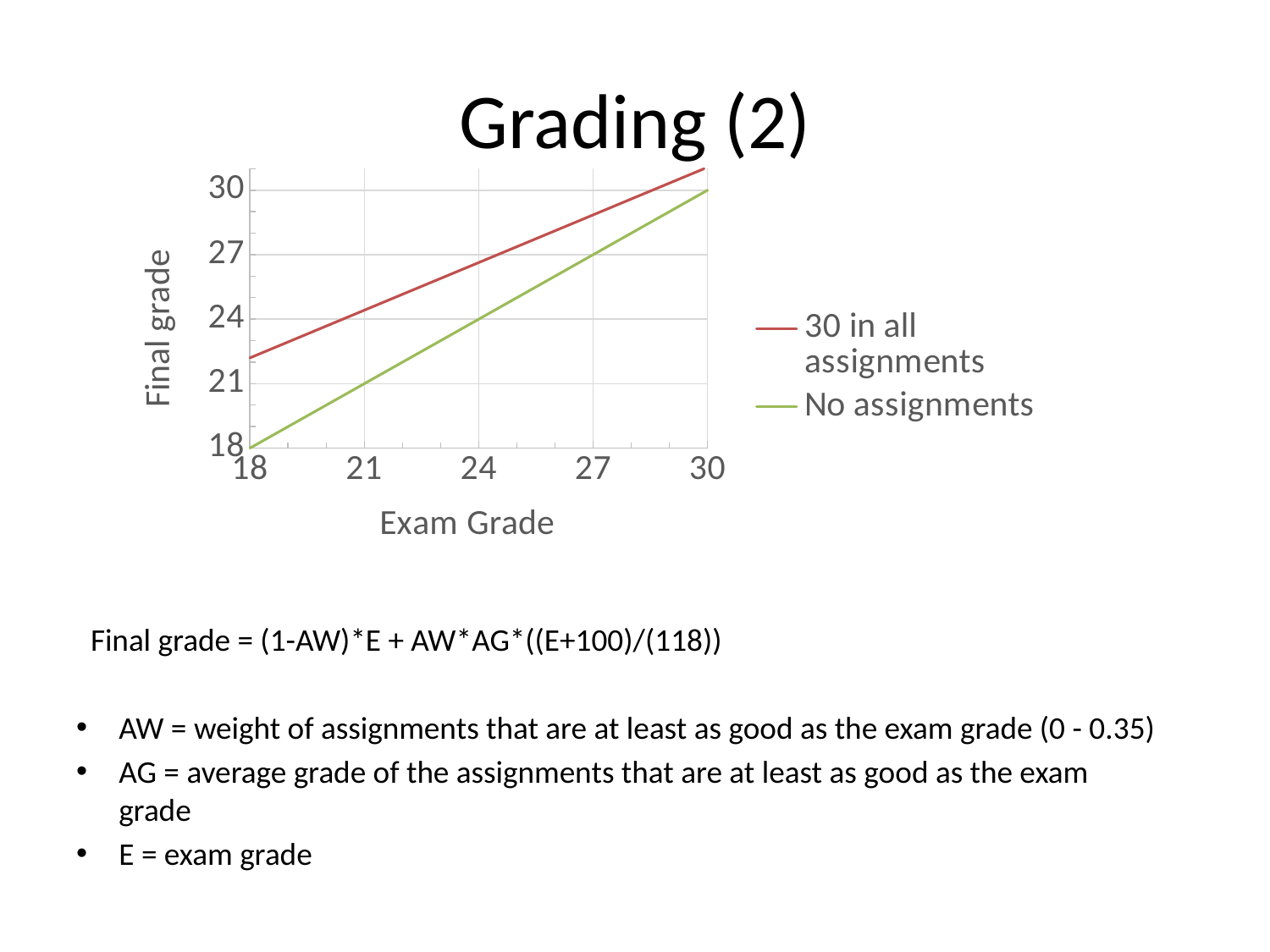
How many series does the chart legend list? 2 Is the final grade for '30 in all assignments' at an exam grade of 18 greater or less than 21? greater What is the title of the x axis of the chart? Exam Grade What is the final grade for the 'No assignments' series at an exam grade of 24? 24 What are the two series named in the chart legend? 30 in all assignments; No assignments At an exam grade of 24, which series has the higher final grade: '30 in all assignments' or 'No assignments'? 30 in all assignments What is the final grade for the 'No assignments' series at an exam grade of 18? 18 Is the final grade for 'No assignments' at an exam grade of 21 greater or less than 24? less Is the final grade for '30 in all assignments' at an exam grade of 30 greater or less than 30? greater What kind of chart is shown on the slide? line chart Do the final grade values rise or fall as the exam grade increases along the x axis? rise What is the final grade for the 'No assignments' series at an exam grade of 30? 30